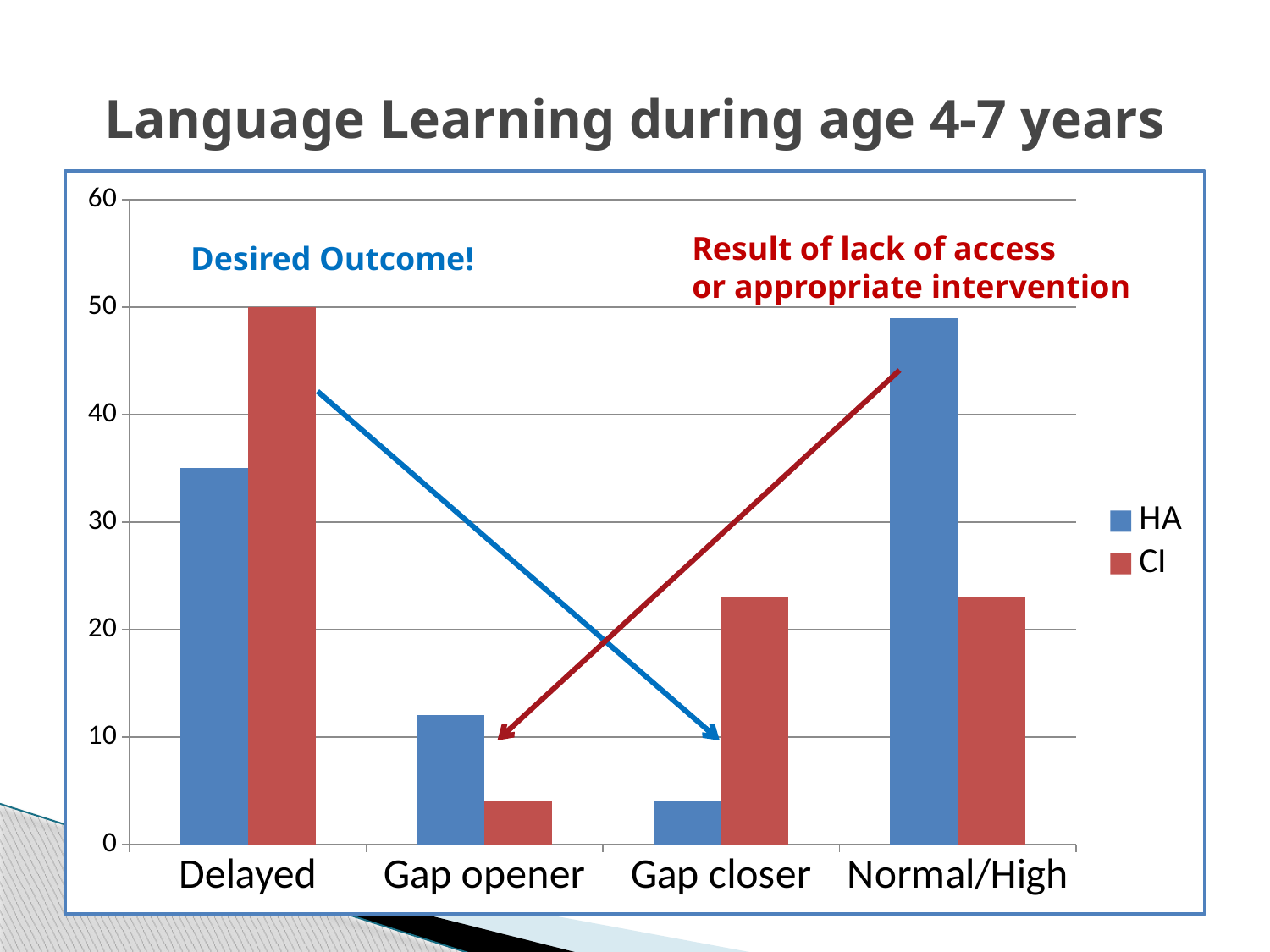
Which category has the lowest CI value? Gap opener How many categories are shown on the x axis? 4 What is the title of the chart? Language Learning during age 4-7 years Is the HA value for Delayed greater or less than 30? greater What is the CI value for the Delayed category? 50 Which category has the lowest HA value? Gap closer Is the CI value for Gap opener greater or less than 10? less What type of chart is shown on the slide? bar chart Which category has the highest CI value? Delayed How many series does the legend list? 2 Which category has the highest HA value? Normal/High In the Delayed category, which is larger, HA or CI? CI